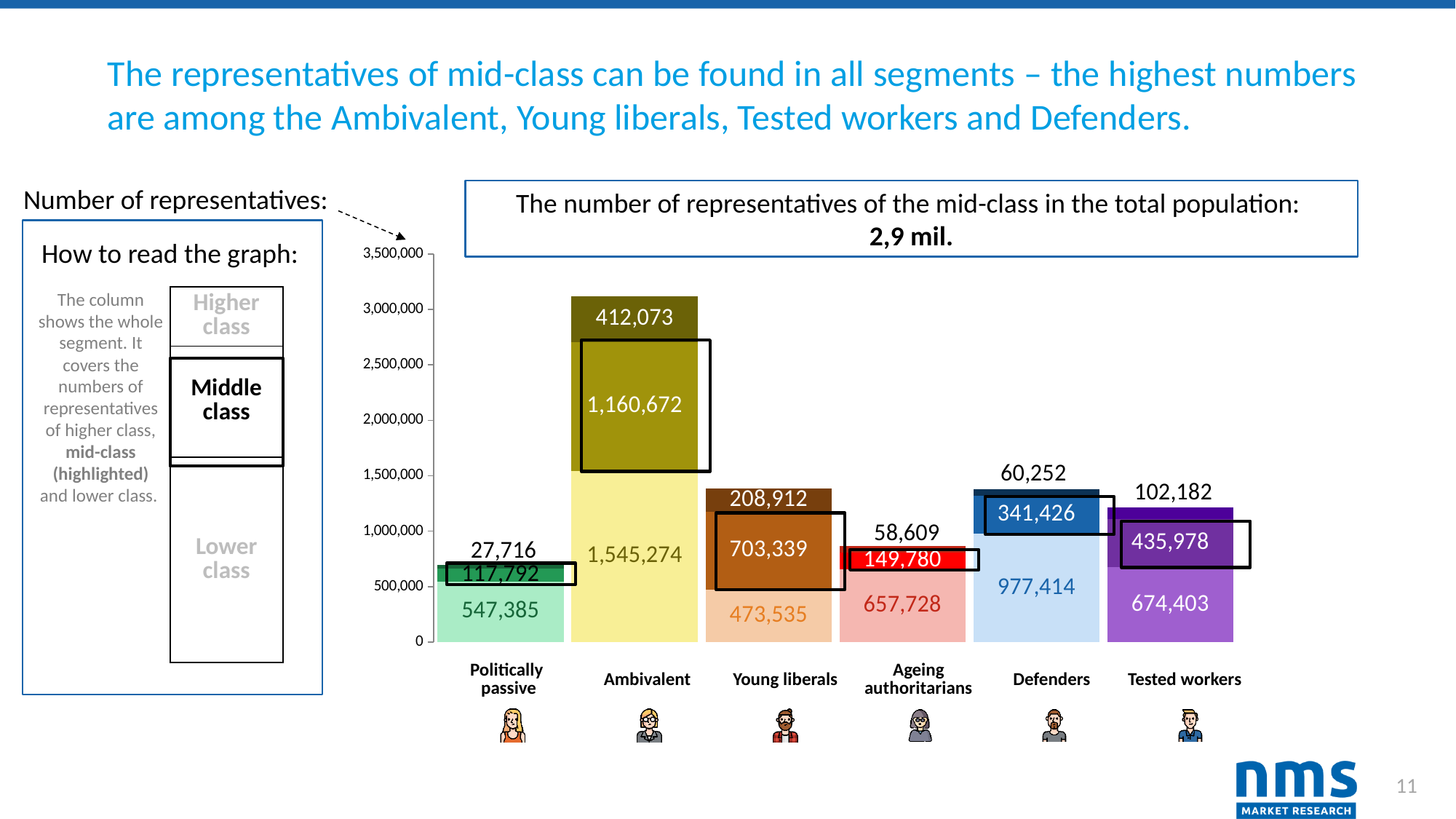
Which segment has the highest number of middle-class representatives? Ambivalent How many segments (categories) are shown on the x axis of the chart? 6 What is the difference between the middle-class values for Ambivalent and Young liberals? 457,333 What kind of chart is shown on the slide? bar chart What is the number of higher-class representatives among Tested workers? 102,182 According to the box above the chart, what is the number of representatives of the mid-class in the total population? 2,9 mil. Which has more lower-class representatives, Defenders or Ageing authoritarians? Defenders What is the number of middle-class representatives among the Ambivalent segment? 1,160,672 What is the number of lower-class representatives among Defenders? 977,414 What is the total number of representatives in the Politically passive segment (all three classes combined)? 692,893 Which segment has the lowest number of middle-class representatives? Politically passive What is the total number of representatives in the Tested workers segment (all three classes combined)? 1,212,563